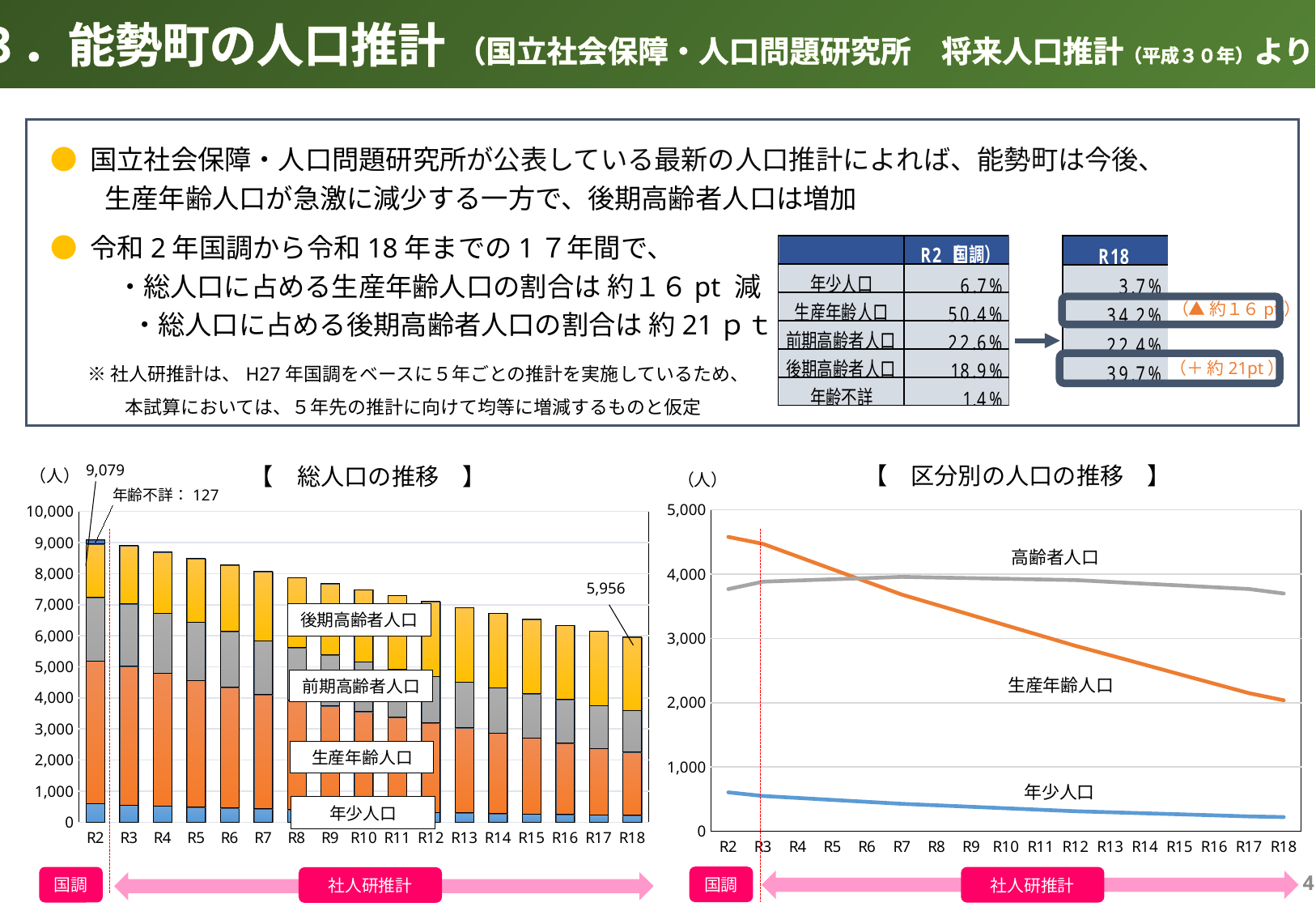
In the 総人口の推移 chart, what value is given for 年齢不詳 in R2? 127 In the 区分別の人口の推移 chart, which line is the highest at R18? 高齢者人口 How many years (bars) are shown on the x axis of the 総人口の推移 chart? 17 In the 総人口の推移 chart, which year has the highest total population? R2 In the 区分別の人口の推移 chart, is the value of 生産年齢人口 at R18 greater or less than 3,000? less In the 総人口の推移 chart, what is the total population labelled for R2? 9,079 How many lines are plotted in the 区分別の人口の推移 chart? 3 What kind of chart is the 区分別の人口の推移 chart on the right? line chart In the 総人口の推移 chart, what is the total population labelled for R18? 5,956 In the 総人口の推移 chart, what is the difference between the R2 total (9,079) and the R18 total (5,956)? 3,123 In the 区分別の人口の推移 chart, does the 生産年齢人口 line rise or fall from R2 to R18? fall What kind of chart is the 総人口の推移 chart on the left? bar chart